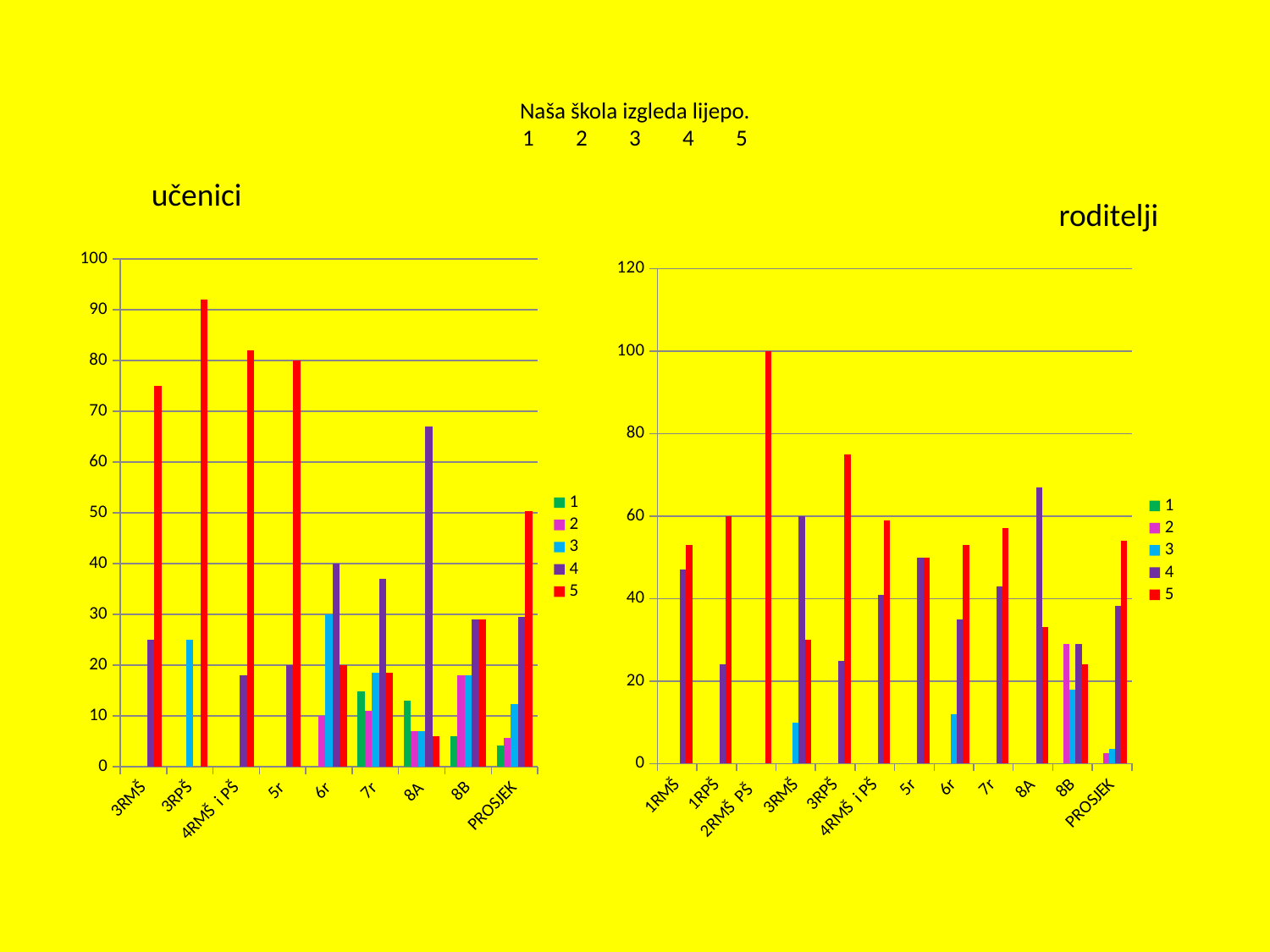
In the 'roditelji' chart, which category has the highest value for series 5? 2RMŠ PŠ In the 'roditelji' chart, is the value of series 4 for 8A greater or less than 60? greater In the 'učenici' chart, what is the value of series 5 for 5r? 80 In the 'učenici' chart, what is the value of series 4 for 6r? 40 In the 'roditelji' chart, what is the value of series 5 for 2RMŠ PŠ? 100 How many categories are shown on the x axis of the 'učenici' chart? 9 What kind of chart is the 'učenici' chart on the left? bar chart In the 'učenici' chart, for category 8A, which is larger: series 4 or series 5? series 4 How many categories are shown on the x axis of the 'roditelji' chart? 12 In the 'učenici' chart, which category has the highest value for series 5? 3RPŠ How many series does the legend of the 'roditelji' chart list? 5 In the 'učenici' chart, is the value of series 5 for 3RMŠ greater or less than 70? greater